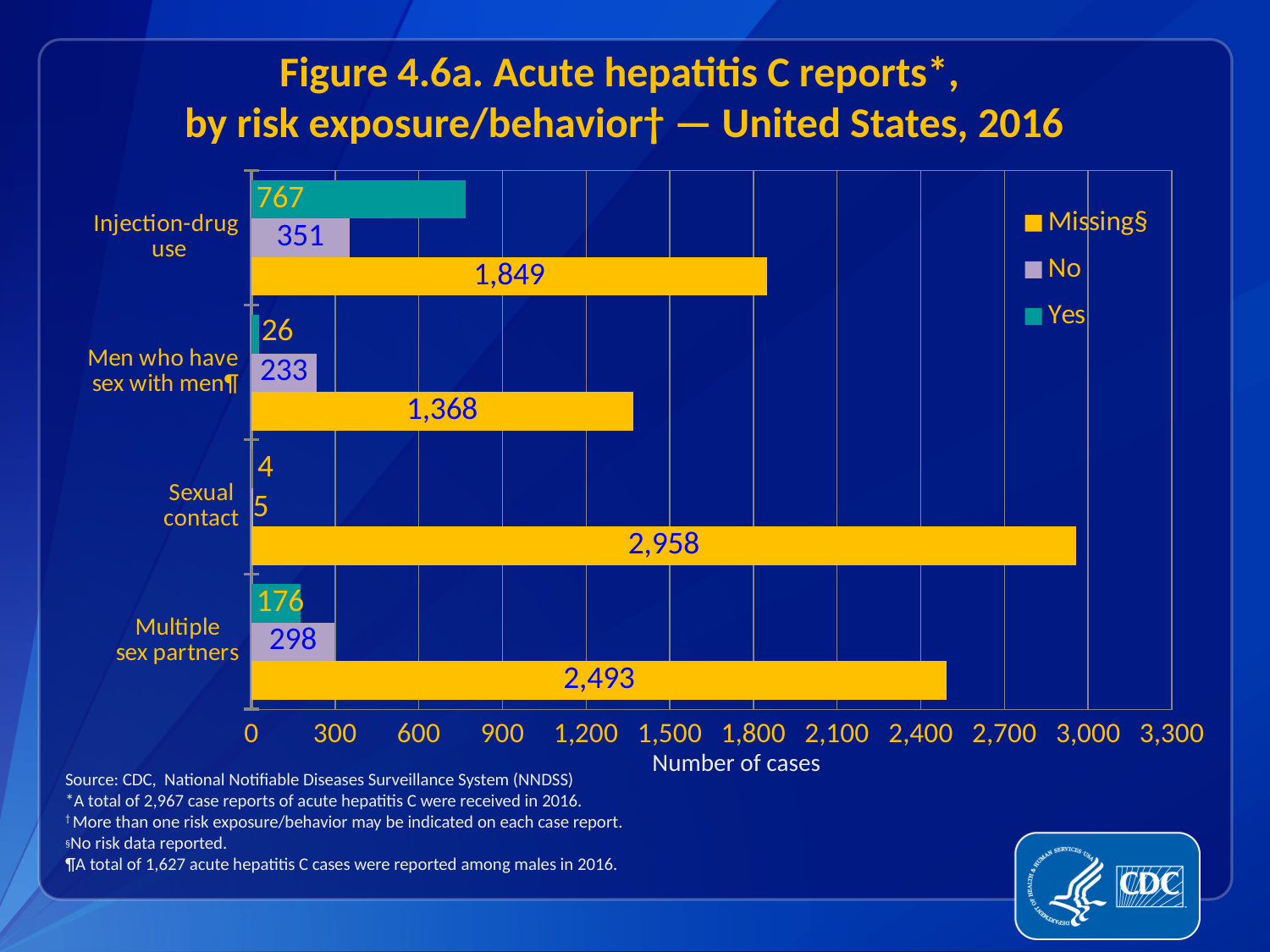
What is the number of cases with 'Missing' for Sexual contact? 2,958 What colour represents the 'Missing§' series in the legend? Yellow What is the number of cases with 'No' for Multiple sex partners? 298 Which category has the highest 'Missing' value? Sexual contact What type of chart is shown on the slide? Bar chart Which category has the lowest 'Yes' value? Sexual contact Which is larger for Men who have sex with men: the 'Yes' value or the 'No' value? No What is the number of cases with 'Yes' for Injection-drug use? 767 What is the label of the x axis? Number of cases How many series does the legend list? 3 How many risk exposure/behavior categories are shown on the chart? 4 What is the difference between the 'Missing' values for Multiple sex partners and Injection-drug use? 644